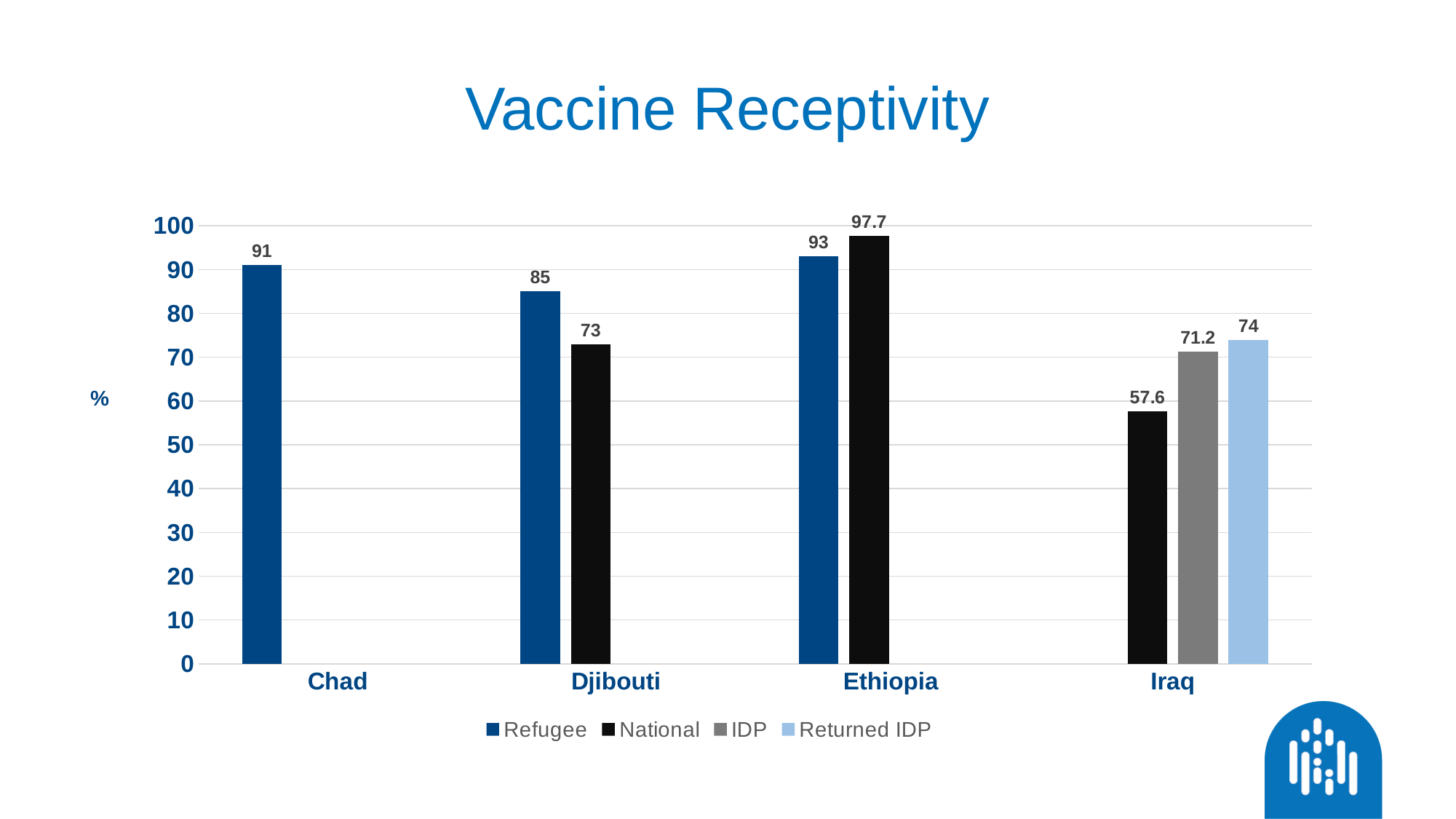
What is the Returned IDP value for Iraq? 74 How many countries are shown on the x axis? 4 How many series does the legend list? 4 What is the difference between the Refugee and National values for Djibouti? 12 What is the title of the chart? Vaccine Receptivity What is the National value for Ethiopia? 97.7 What is the Refugee value for Chad? 91 Which country has the highest National value? Ethiopia Which country has the lowest National value? Iraq Which is larger for Ethiopia, the Refugee value or the National value? National What is the IDP value for Iraq? 71.2 What kind of chart is shown? Bar chart